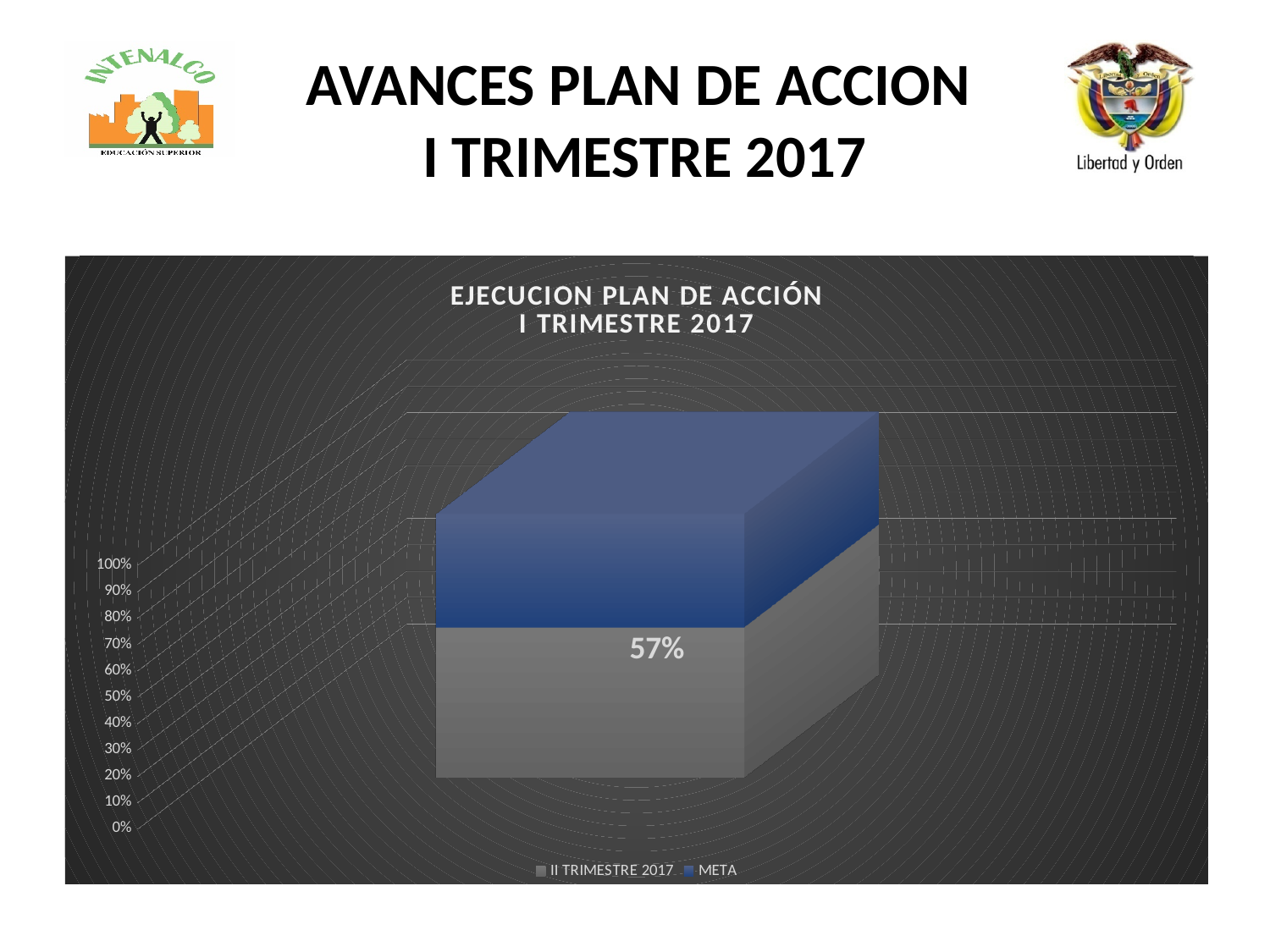
What is the title of the chart? EJECUCION PLAN DE ACCIÓN I TRIMESTRE 2017 Is the value for II TRIMESTRE 2017 greater or less than 50%? greater How many bars are plotted in the chart? 1 How many series does the legend list? 2 What is the highest value shown on the vertical axis? 100% What kind of chart is shown on the slide? bar chart What is the value shown for II TRIMESTRE 2017? 57% Which series is shown in blue in the legend? META